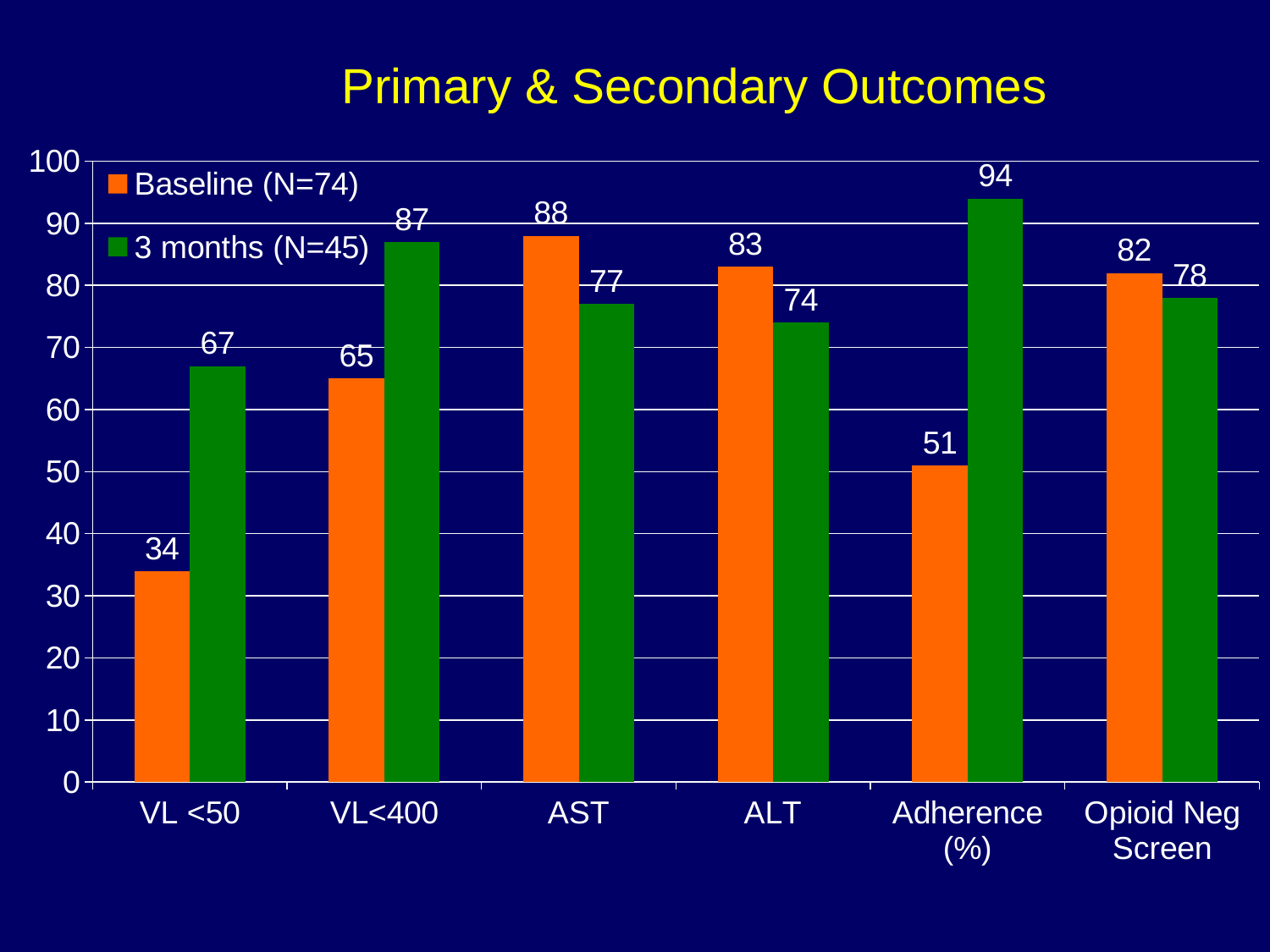
Which category has the lowest 3 months (N=45) value? VL <50 How many categories are shown on the x axis? 6 What is the difference between the Baseline (N=74) and 3 months (N=45) values for AST? 11 What is the 3 months (N=45) value for Adherence (%)? 94 How many series does the legend list? 2 What is the difference between the 3 months (N=45) and Baseline (N=74) values for Adherence (%)? 43 What kind of chart is shown on the slide? bar chart Which category has the highest Baseline (N=74) value? AST What is the Baseline (N=74) value for VL <50? 34 Which is larger for ALT, the Baseline (N=74) value or the 3 months (N=45) value? Baseline (N=74) Is the Baseline (N=74) value for VL<400 greater or less than 70? less What is the 3 months (N=45) value for Opioid Neg Screen? 78